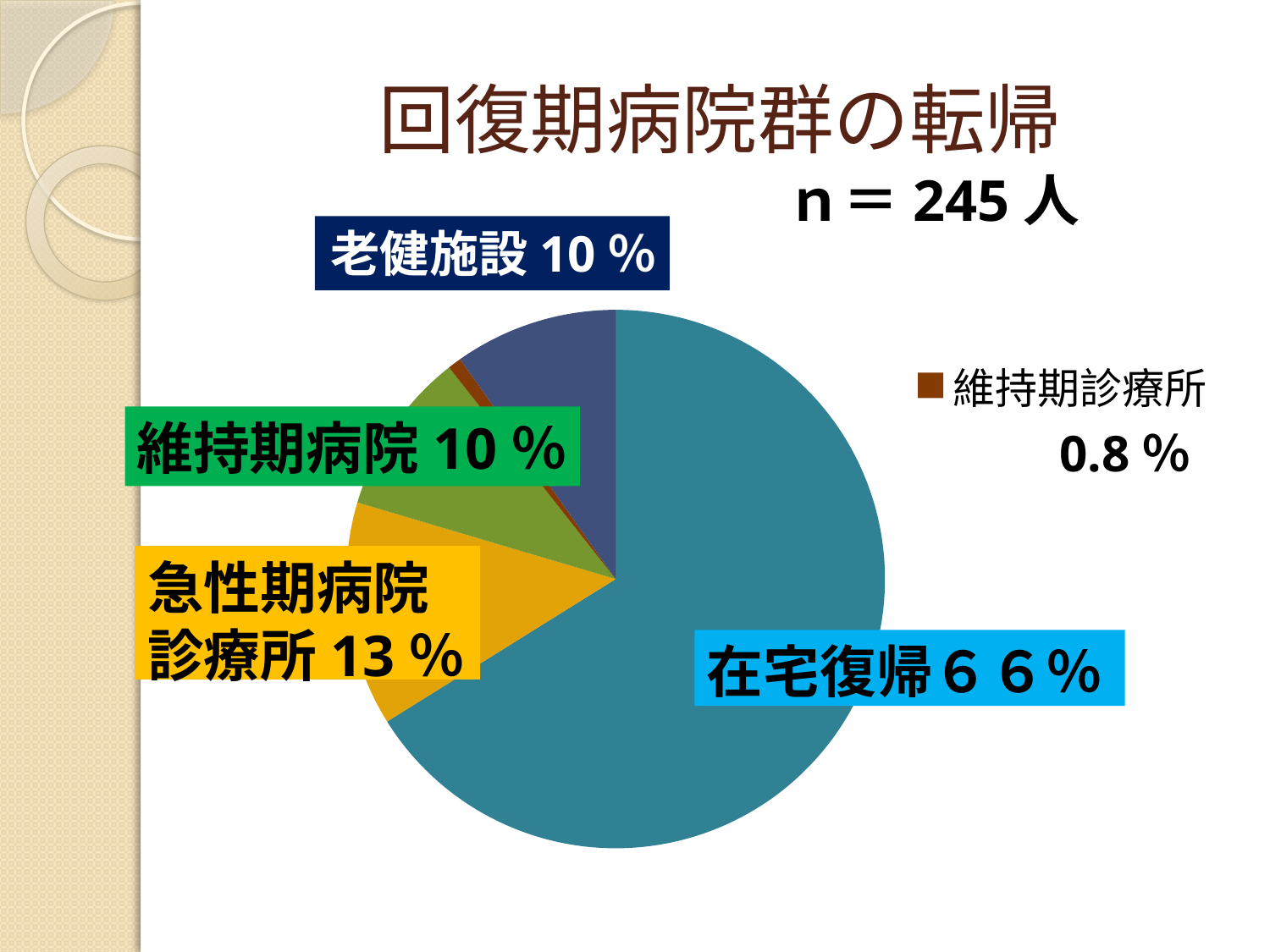
What percentage is labelled for 急性期病院診療所? 13% What percentage is labelled for 維持期診療所? 0.8% How many slices does the pie chart have? 5 What is the title of the chart? 回復期病院群の転帰 What percentage of the pie is 在宅復帰? 66% What is the sample size (n) shown on the slide? 245 人 Which category has the largest share of the pie? 在宅復帰 What kind of chart is shown on the slide? pie chart What is the difference in percentage points between 在宅復帰 and 急性期病院診療所? 53 What percentage is labelled for 維持期病院? 10% What percentage is labelled for 老健施設? 10% Which category has the smallest share of the pie? 維持期診療所